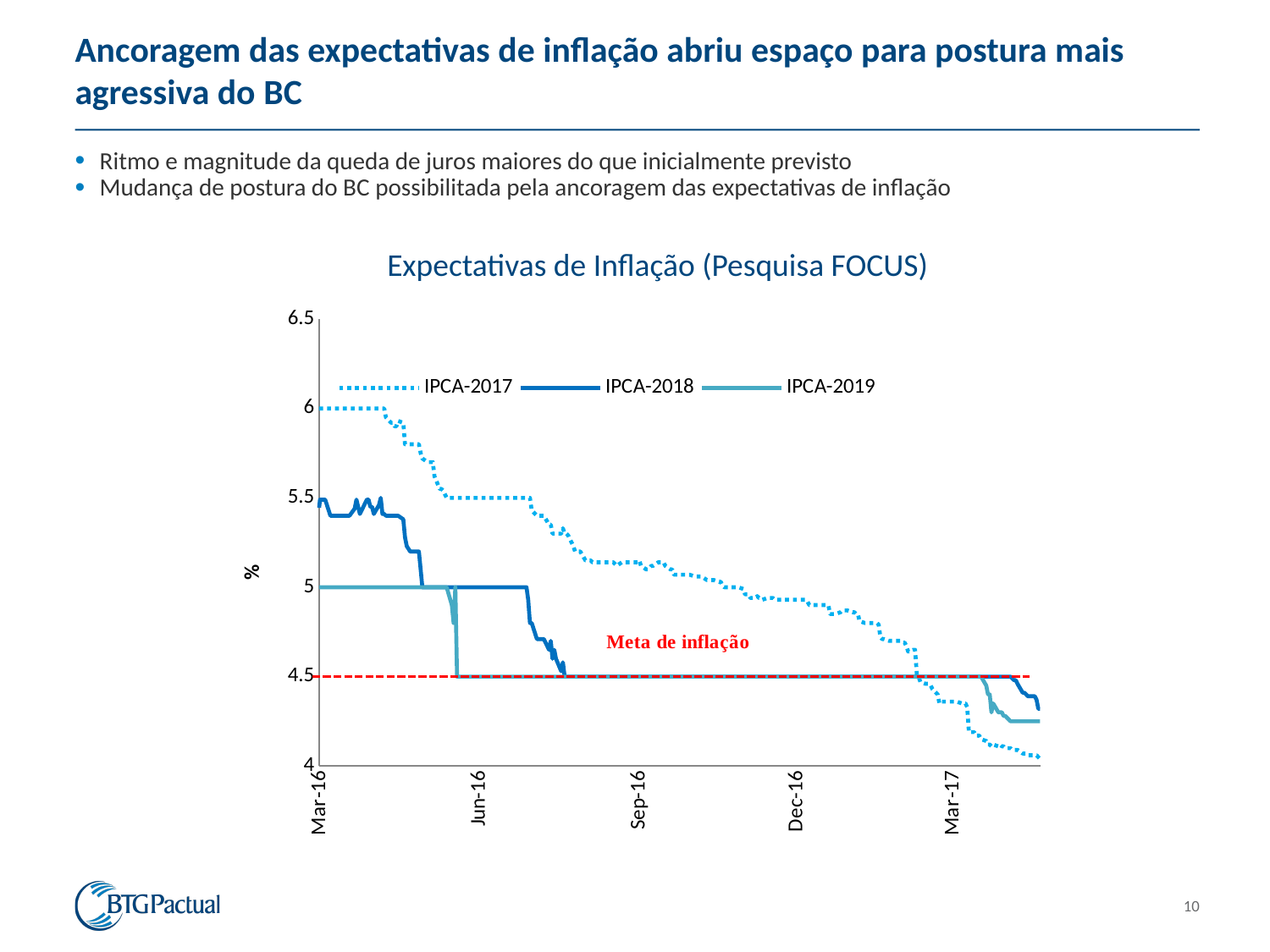
What kind of chart is shown on the slide? line chart Which series has the lowest value at Mar-16? IPCA-2019 How many series does the chart legend list? 3 Which series is drawn as a dotted line? IPCA-2017 At Dec-16, which is larger: IPCA-2017 or IPCA-2018? IPCA-2017 Is the value of IPCA-2017 at Dec-16 greater or less than 5? less At what level is the red dashed 'Meta de inflação' line drawn? 4.5 What is the title of the chart? Expectativas de Inflação (Pesquisa FOCUS) Which series has the highest value at Mar-16? IPCA-2017 Is the value of IPCA-2018 at Dec-16 greater or less than 5? less Is the value of IPCA-2017 at Mar-16 greater or less than 5.5? greater Does the IPCA-2017 series rise or fall from Mar-16 to Mar-17? fall